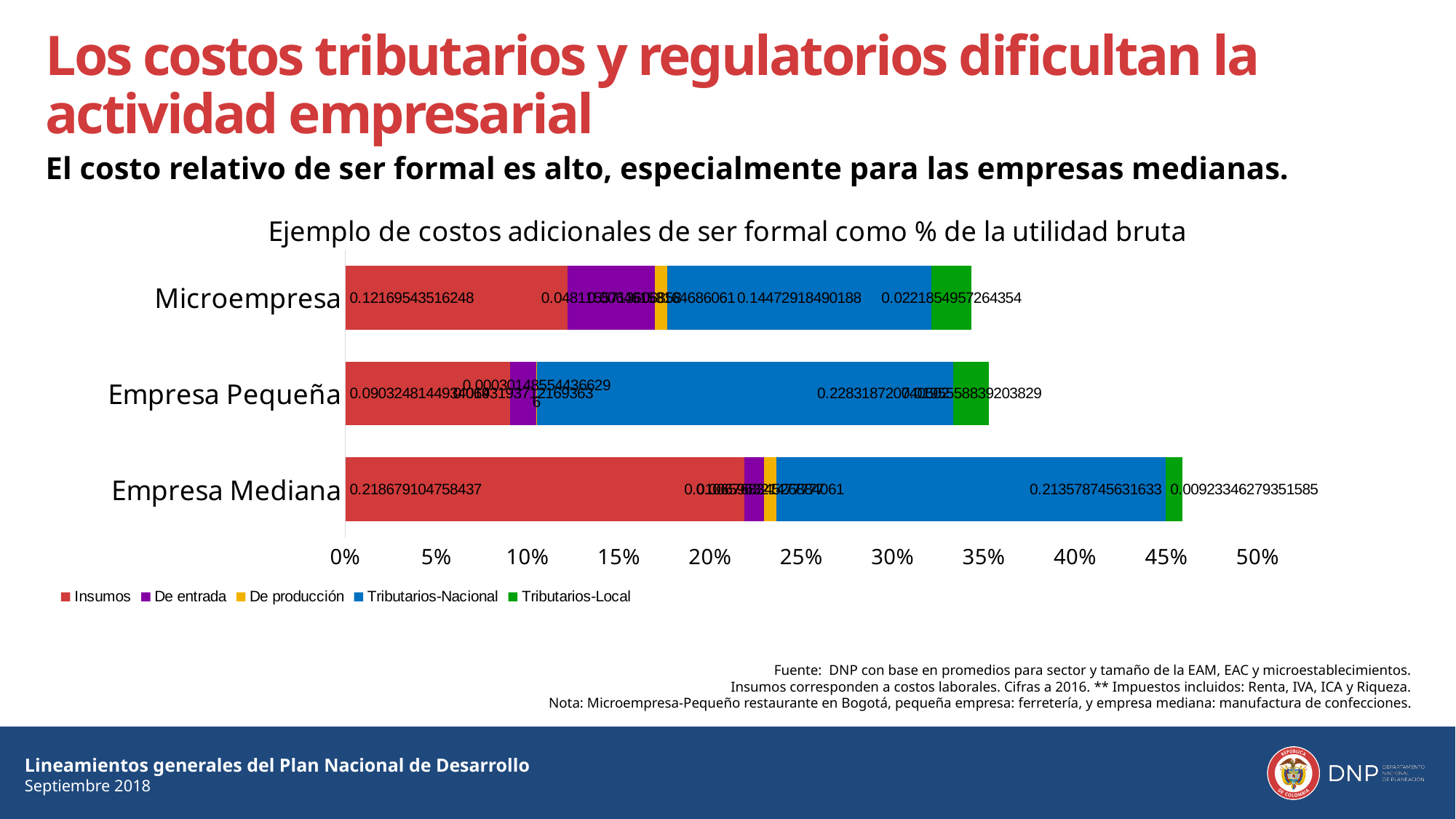
What is the Tributarios-Nacional value for Empresa Mediana? 0.213578745631633 What is the Tributarios-Local value for Microempresa? 0.0221854957264354 How many series does the chart legend list? 5 How many categories (company sizes) are shown on the chart? 3 What is the Tributarios-Local value for Empresa Mediana? 0.00923346279351585 What kind of chart is shown on the slide? Stacked bar chart Is the total bar for Empresa Mediana greater or less than 40%? greater What is the Tributarios-Nacional value for Microempresa? 0.14472918490188 What is the Insumos value for Empresa Mediana? 0.218679104758437 Which is larger, the Insumos value for Microempresa or the Insumos value for Empresa Mediana? Empresa Mediana What is the Insumos value for Microempresa? 0.12169543516248 Which company size has the longest total bar? Empresa Mediana